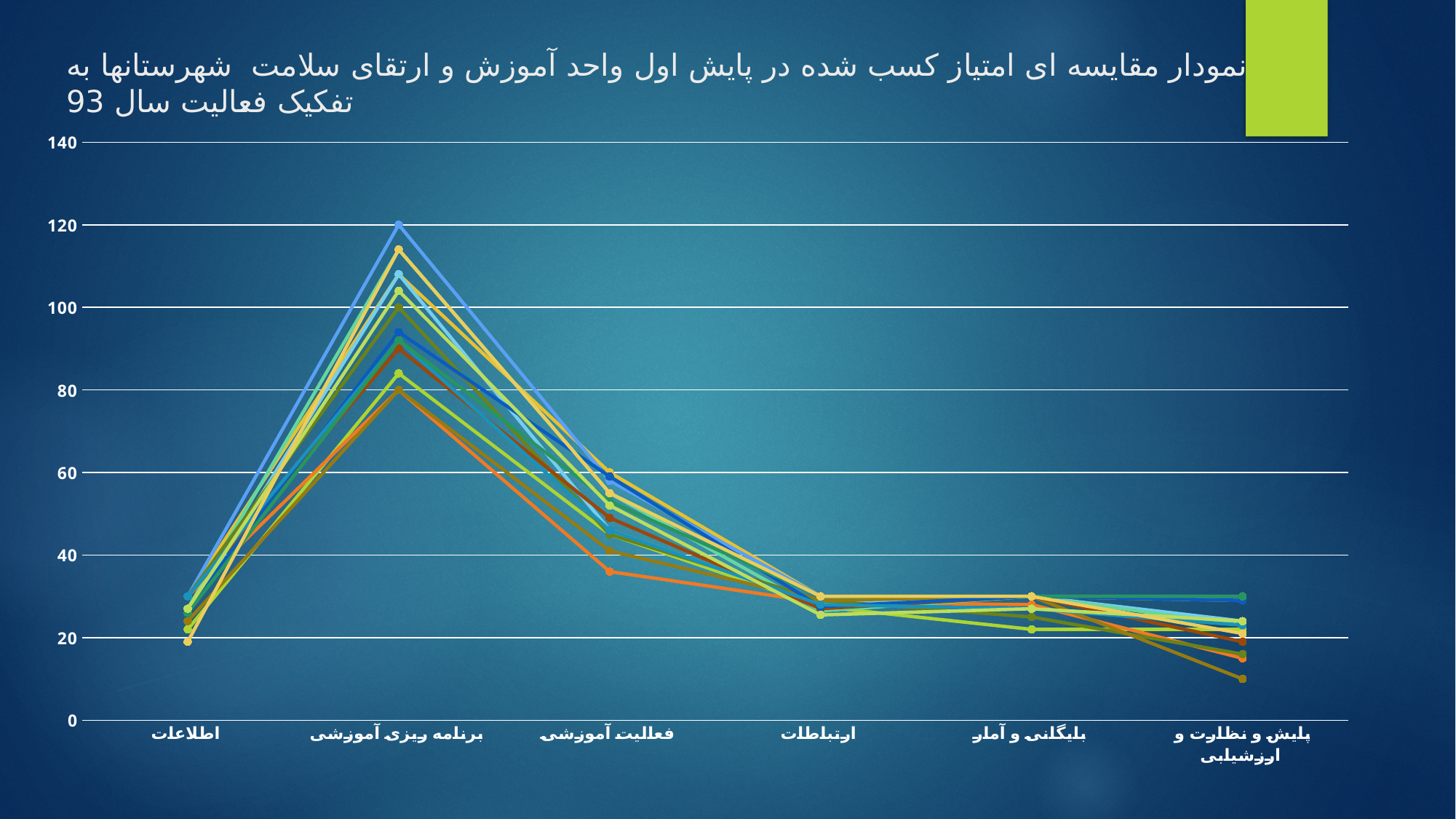
What is the maximum value shown on the y axis of the chart? 140 Is the highest value at برنامه ریزی آموزشی greater or less than 100? greater Is the highest value at اطلاعات greater or less than 40? less How many categories are shown along the x axis of the chart? 6 Is the lowest value at پایش و نظارت و ارزشیابی greater or less than 20? less Which year is mentioned in the chart title? 93 Do the values rise or fall along the x axis from برنامه ریزی آموزشی to ارتباطات? fall At which category do the lines reach their highest values? برنامه ریزی آموزشی What kind of chart is shown on the slide? line chart